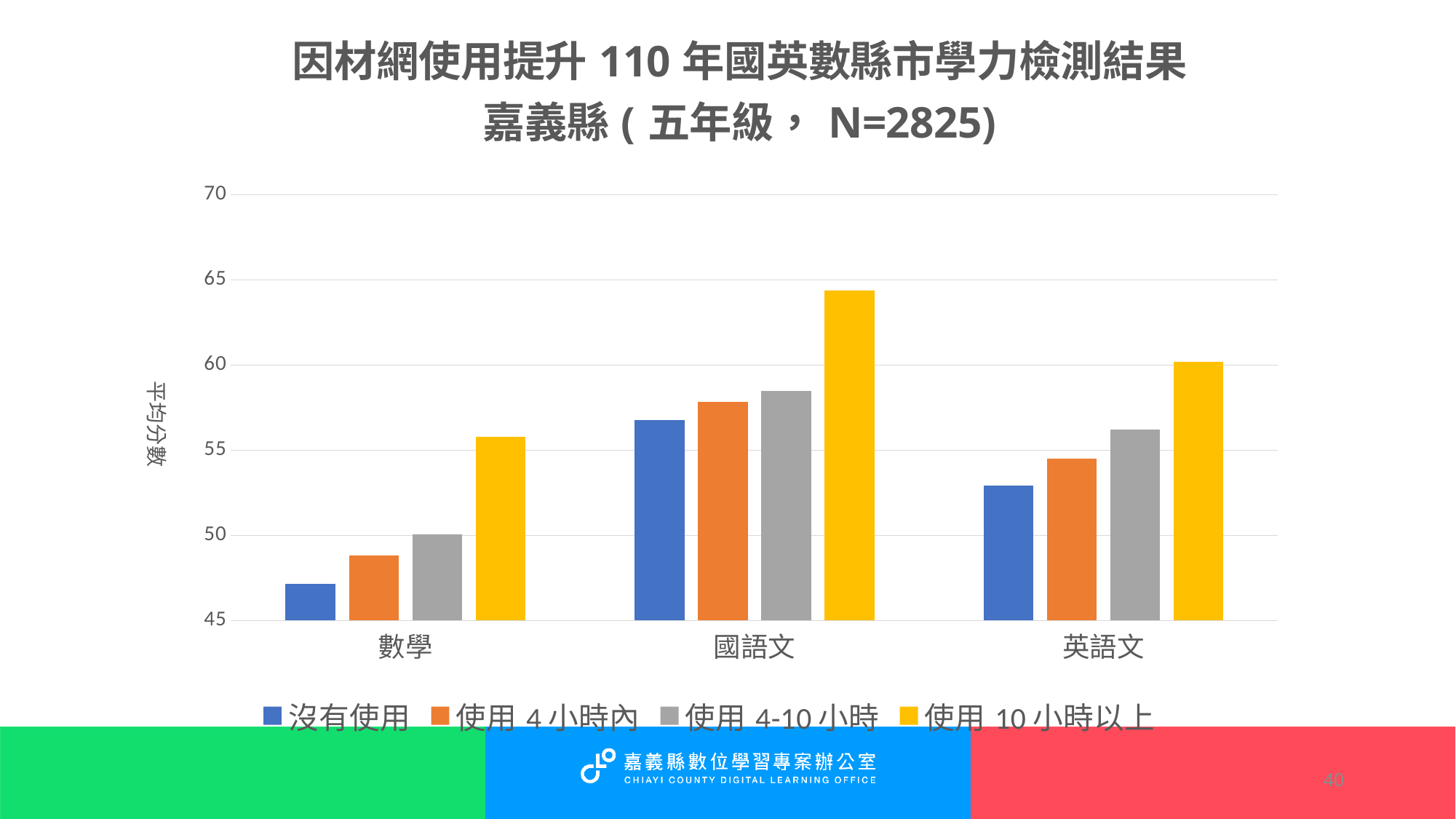
How many subject categories are shown on the x axis? 3 Is the value for 沒有使用 in 數學 greater or less than 50? less Within 國語文, do the values rise or fall from 沒有使用 to 使用 10 小時以上? rise How many series does the legend list? 4 Which subject has the lowest value for 沒有使用? 數學 Within 英語文, which usage group has the lowest average score? 沒有使用 Within 數學, which usage group has the highest average score? 使用 10 小時以上 Is the value for 使用 10 小時以上 in 國語文 greater or less than 60? greater Which is larger: 使用 10 小時以上 in 數學 or 沒有使用 in 國語文? 沒有使用 in 國語文 Is the value for 使用 4-10 小時 in 英語文 greater or less than 55? greater What kind of chart is shown on the slide? bar chart Which subject has the highest value for 使用 10 小時以上? 國語文